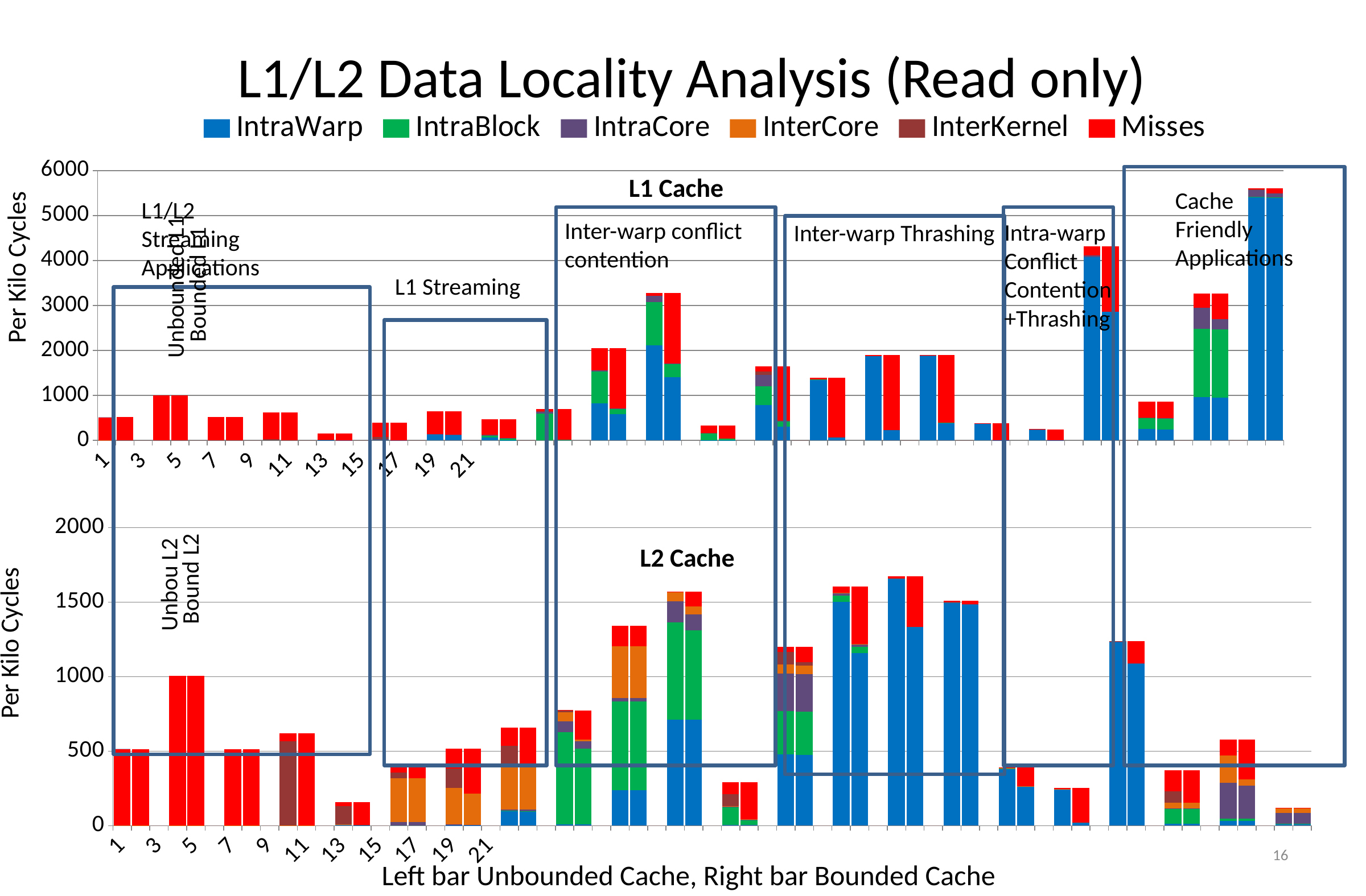
In the L1 Cache chart, is the total for the left bar of category 5 greater or less than 500? greater In the L1 Cache chart, is the total for the left bar of category 17 greater or less than 1000? less According to the caption under the bottom chart, what does the left bar of each pair represent? Unbounded Cache Which series is shown in red in the legend? Misses In the L1 Cache chart, which is taller: the left bar of category 5 or the left bar of category 13? category 5 In the L1 Cache chart, is the total for the left bar of category 13 greater or less than 500? less What kind of chart is the L1 Cache chart at the top of the slide? stacked bar chart How many series does the legend list? 6 In the L1 Cache chart, which labeled application group contains the tallest bars? Cache Friendly Applications